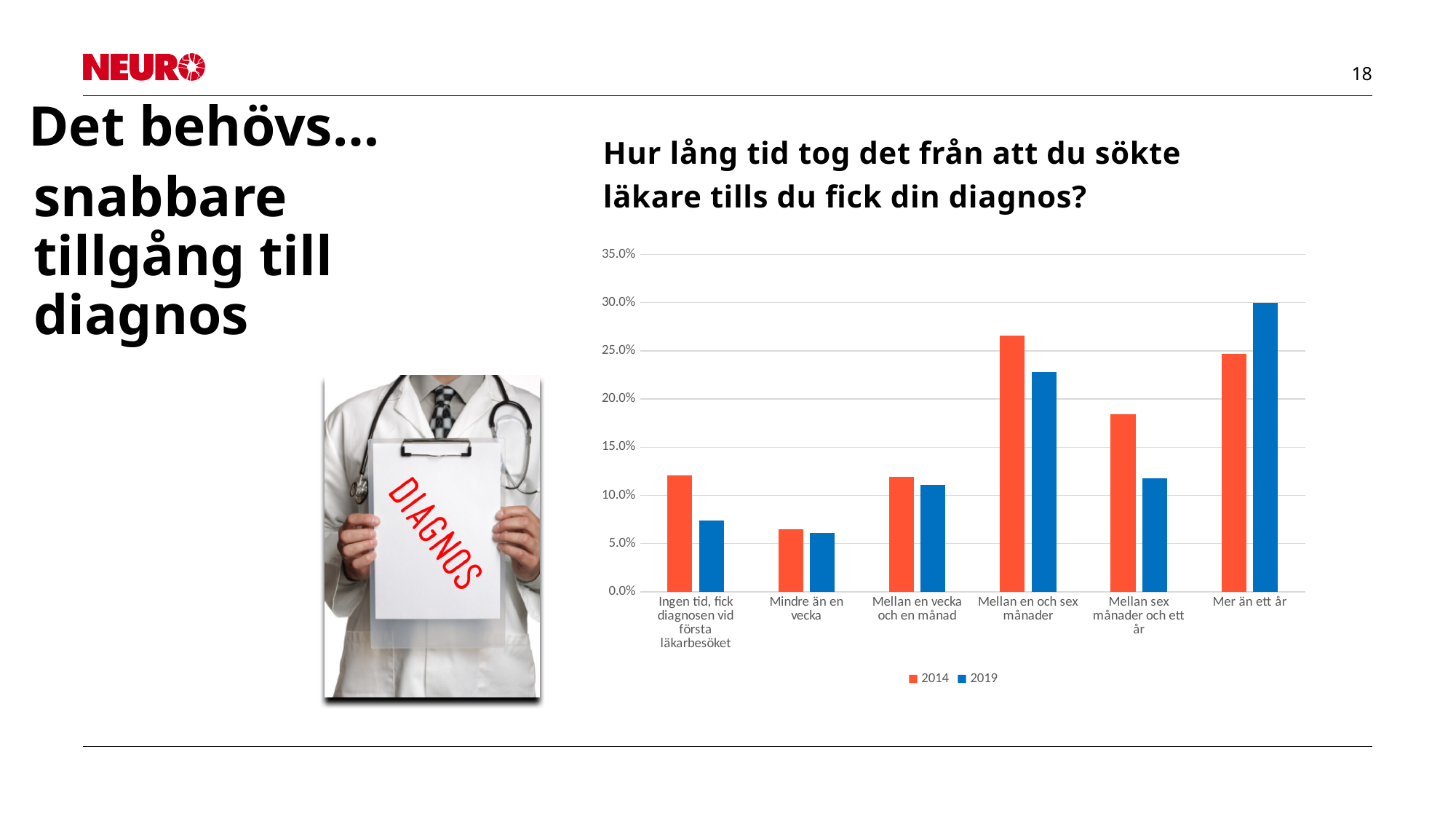
Is the 2014 value for 'Mellan sex månader och ett år' greater or less than 15.0%? greater Is the 2019 value for 'Ingen tid, fick diagnosen vid första läkarbesöket' greater or less than 10.0%? less Which category has the highest value for the 2014 series? Mellan en och sex månader Which category has the lowest value for the 2014 series? Mindre än en vecka What kind of chart is shown on the slide? Bar chart Which category has the highest value for the 2019 series? Mer än ett år How many categories are shown on the x axis of the chart? 6 For 'Mer än ett år', which series has the larger value, 2014 or 2019? 2019 Which series is shown in blue in the chart's legend? 2019 For 'Mellan sex månader och ett år', which series has the larger value, 2014 or 2019? 2014 How many series does the chart's legend list? 2 Is the 2019 value for 'Mer än ett år' greater or less than 25.0%? greater